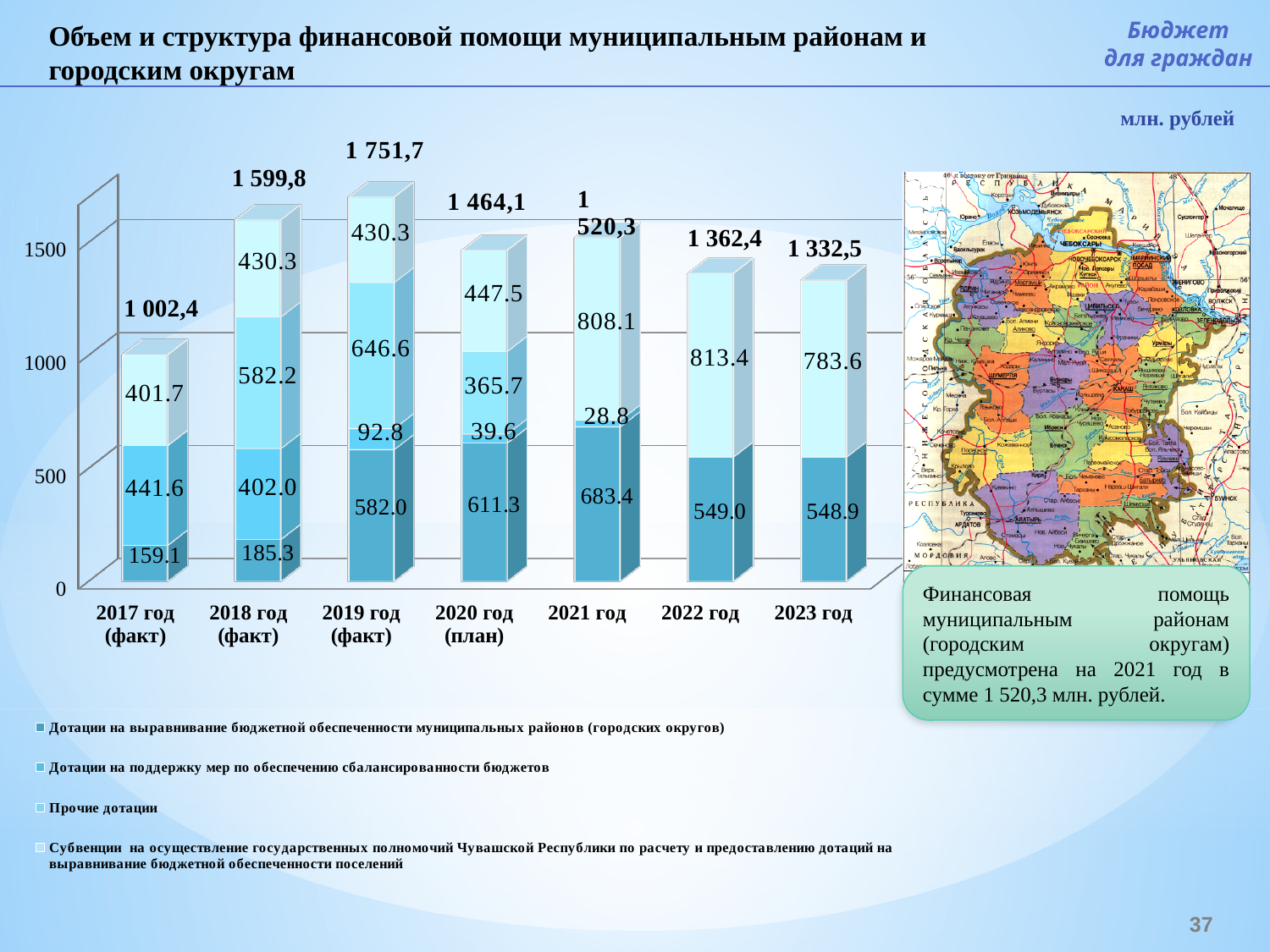
Which year has the highest total financial aid? 2019 год (факт) What is the value of the bottom (darkest) segment of the 2021 год bar? 683.4 Which year has the lowest total financial aid? 2017 год (факт) What is the difference between the totals for 2018 год (факт) and 2017 год (факт)? 597,4 How many years (categories) are shown on the x axis? 7 How many series does the legend list? 4 In what units are the values on the chart expressed? млн. рублей Which total is larger, 2022 год or 2023 год? 2022 год From 2021 год to 2023 год, do the totals rise or fall? fall What is the total financial aid shown above the bar for 2019 год (факт)? 1 751,7 Is the total for 2022 год greater or less than 1500? less What kind of chart is shown on the slide? Stacked bar chart